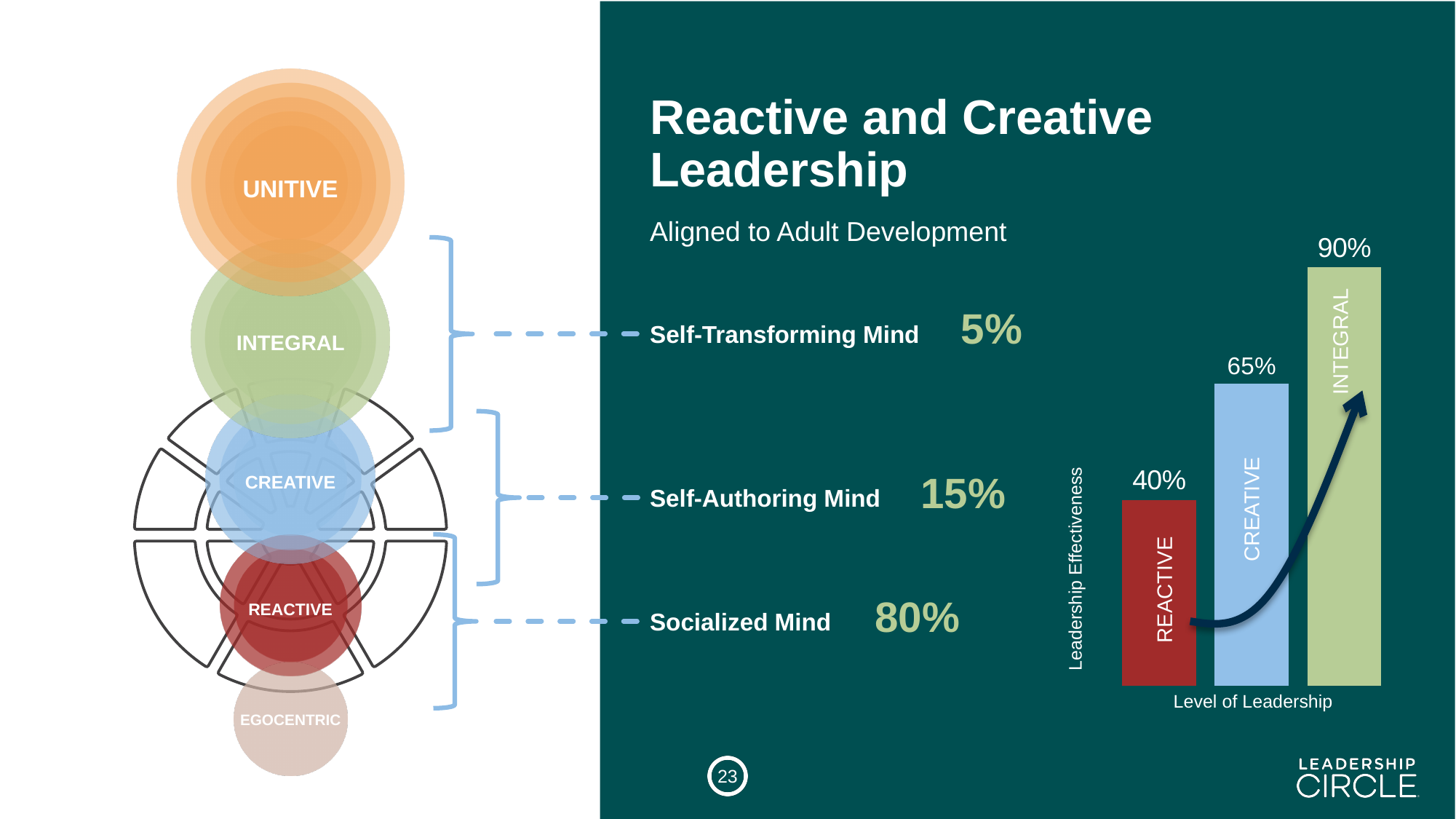
Which is larger in the bar chart, the value for CREATIVE or the value for REACTIVE? CREATIVE What is the difference between the CREATIVE and REACTIVE values in the bar chart? 25% What is the label on the horizontal axis of the bar chart? Level of Leadership Which level of leadership has the lowest leadership effectiveness in the bar chart? REACTIVE What is the value for INTEGRAL in the bar chart? 90% Which level of leadership has the highest leadership effectiveness in the bar chart? INTEGRAL What kind of chart is shown on the right side of the slide? bar chart What is the value for CREATIVE in the bar chart? 65% What is the difference between the INTEGRAL and REACTIVE values in the bar chart? 50% Do the values in the bar chart rise or fall from REACTIVE to INTEGRAL? rise What is the value for REACTIVE in the bar chart? 40% How many bars are shown in the bar chart? 3